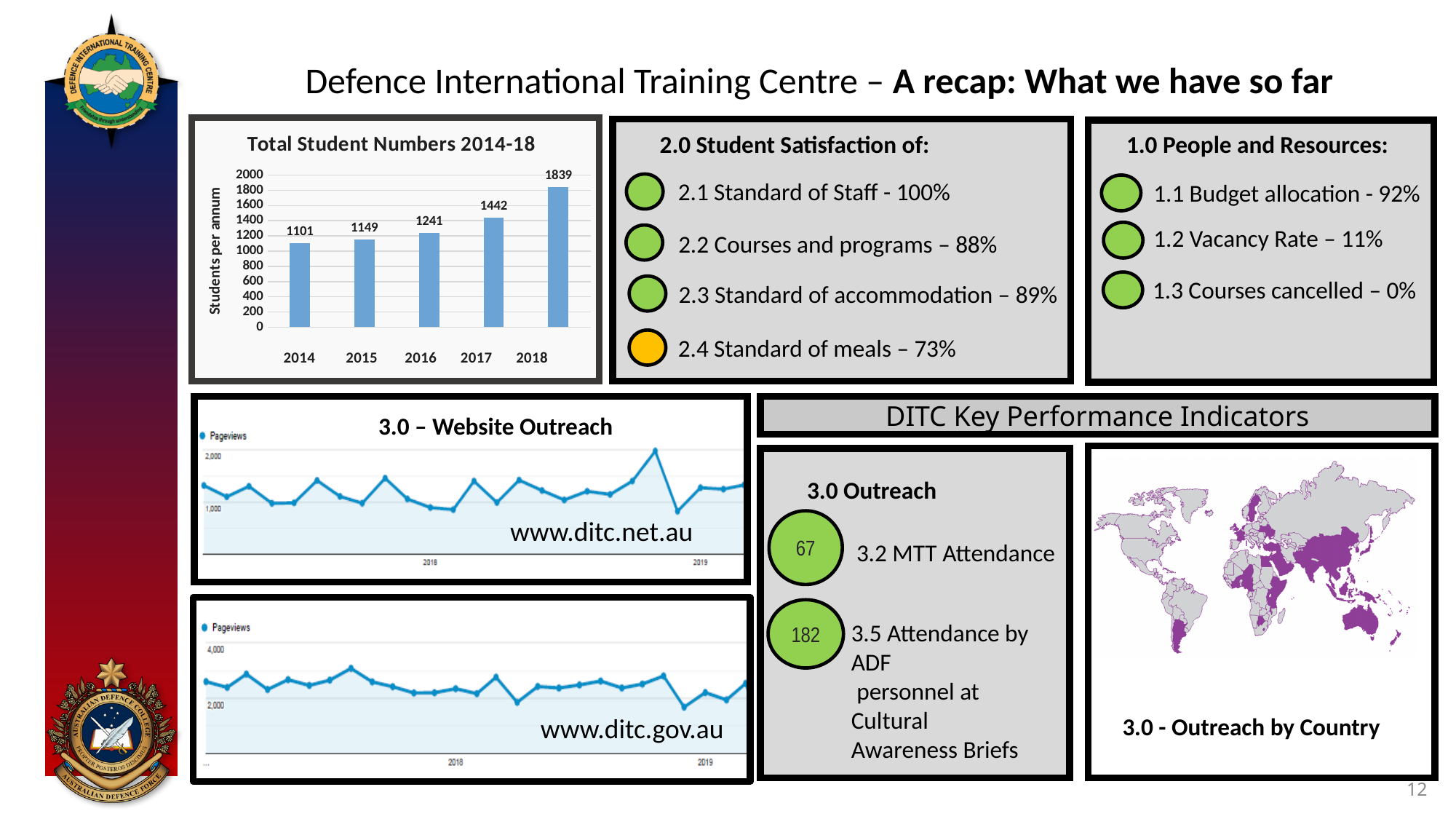
In the Total Student Numbers 2014-18 chart, what was the number of students in 2014? 1101 How many years are shown in the Total Student Numbers 2014-18 chart? 5 In the Total Student Numbers 2014-18 chart, what was the number of students in 2017? 1442 In the Total Student Numbers 2014-18 chart, what was the number of students in 2018? 1839 In the Total Student Numbers 2014-18 chart, what is the difference between the 2018 and 2017 student numbers? 397 In the Total Student Numbers 2014-18 chart, which year had the highest number of students? 2018 In the Total Student Numbers 2014-18 chart, do student numbers rise or fall from 2014 to 2018? Rise What is the y-axis label of the Total Student Numbers 2014-18 chart? Students per annum In the Total Student Numbers 2014-18 chart, what is the difference between the 2016 and 2015 student numbers? 92 In the Total Student Numbers 2014-18 chart, which year had more students, 2015 or 2016? 2016 What kind of chart is the Total Student Numbers 2014-18 chart? Bar chart In the Total Student Numbers 2014-18 chart, which year had the lowest number of students? 2014